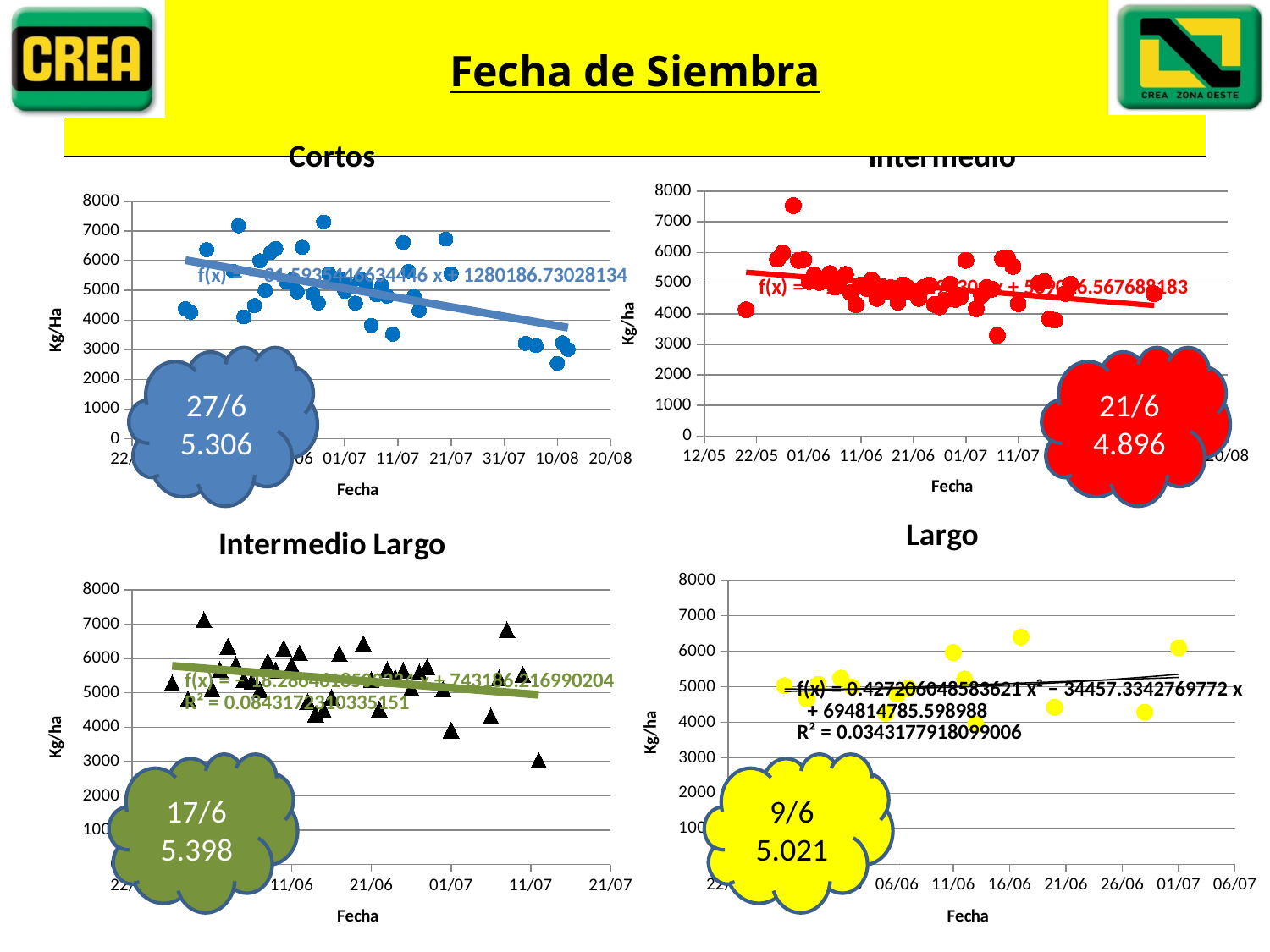
What kind of chart is the "Cortos" chart? scatter chart In the "Intermedio" chart, is the highest plotted point greater or less than 7000 Kg/ha? greater In the "Cortos" chart, is the lowest plotted point greater or less than 3000 Kg/Ha? less What date and value are shown in the cloud callout on the "Largo" chart? 9/6, 5.021 What R² value is printed on the "Largo" chart? 0.0343177918099006 What is the title of the y axis on the "Intermedio Largo" chart? Kg/ha In the "Largo" chart, is the highest plotted point greater or less than 6000 Kg/ha? greater In the "Cortos" chart, does the trendline rise or fall along the x axis? fall In the "Intermedio Largo" chart, does the trendline rise or fall along the x axis? fall How many charts are shown on the slide? 4